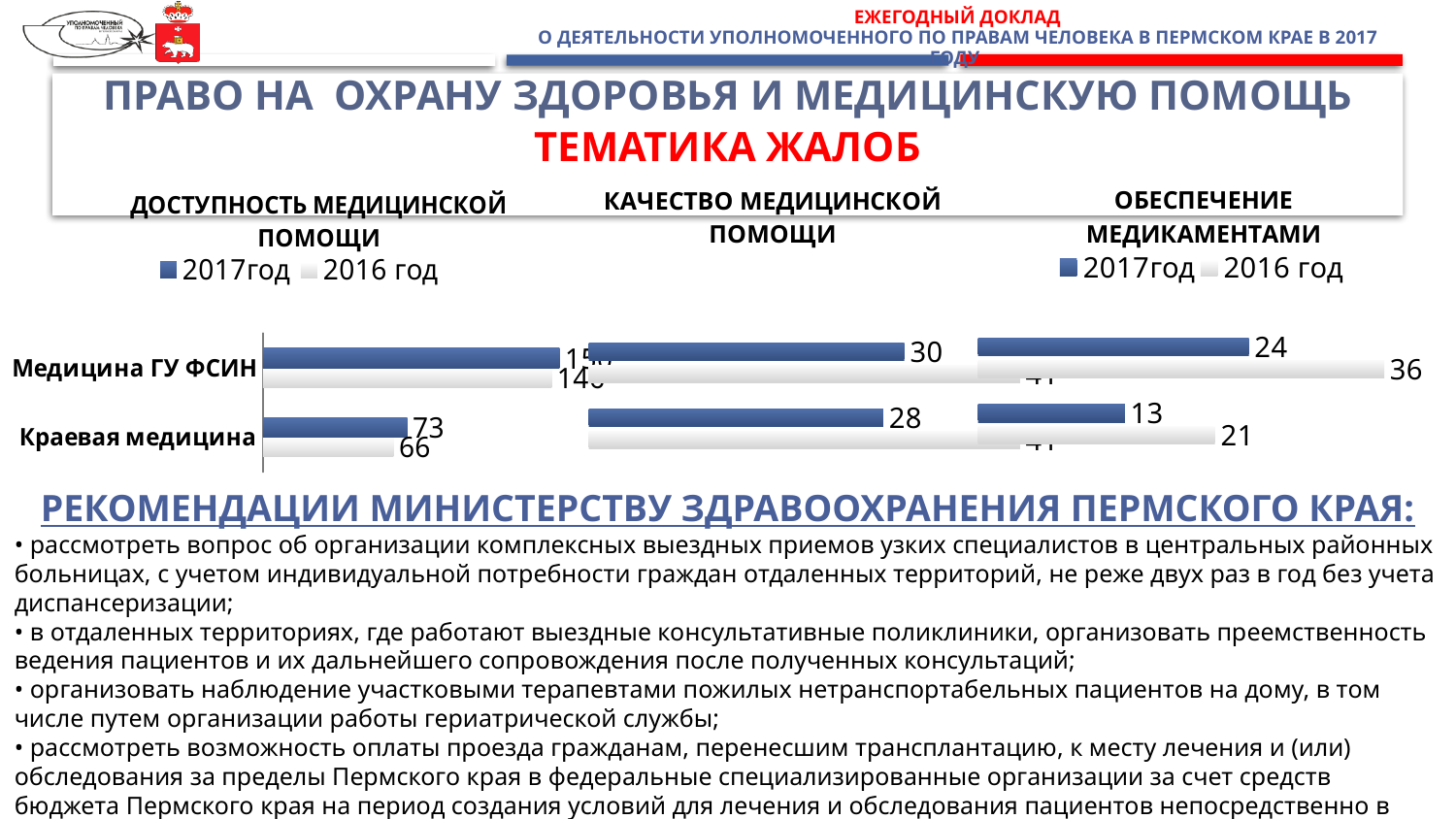
In the chart titled «КАЧЕСТВО МЕДИЦИНСКОЙ ПОМОЩИ», which category has the larger 2017 год value: «Медицина ГУ ФСИН» or «Краевая медицина»? Медицина ГУ ФСИН What kind of chart is the chart titled «КАЧЕСТВО МЕДИЦИНСКОЙ ПОМОЩИ»? Bar chart In the chart titled «ОБЕСПЕЧЕНИЕ МЕДИКАМЕНТАМИ», what is the difference between the 2016 год and 2017 год values for «Медицина ГУ ФСИН»? 12 In the chart titled «ДОСТУПНОСТЬ МЕДИЦИНСКОЙ ПОМОЩИ», by how much did the value for «Краевая медицина» change from 2016 год to 2017 год? 7 How many series does the legend of the chart titled «ОБЕСПЕЧЕНИЕ МЕДИКАМЕНТАМИ» list? 2 In the chart titled «КАЧЕСТВО МЕДИЦИНСКОЙ ПОМОЩИ», what is the value for «Медицина ГУ ФСИН» in 2017 год? 30 In the chart titled «ОБЕСПЕЧЕНИЕ МЕДИКАМЕНТАМИ», what is the value for «Медицина ГУ ФСИН» in 2016 год? 36 In the chart titled «ОБЕСПЕЧЕНИЕ МЕДИКАМЕНТАМИ», which category has the higher 2016 год value? Медицина ГУ ФСИН In the chart titled «ДОСТУПНОСТЬ МЕДИЦИНСКОЙ ПОМОЩИ», what is the value for «Краевая медицина» in 2016 год? 66 In the chart titled «КАЧЕСТВО МЕДИЦИНСКОЙ ПОМОЩИ», what is the value for «Краевая медицина» in 2017 год? 28 In the chart titled «ДОСТУПНОСТЬ МЕДИЦИНСКОЙ ПОМОЩИ», what is the value for «Краевая медицина» in 2017 год? 73 In the chart titled «ОБЕСПЕЧЕНИЕ МЕДИКАМЕНТАМИ», what is the value for «Краевая медицина» in 2017 год? 13